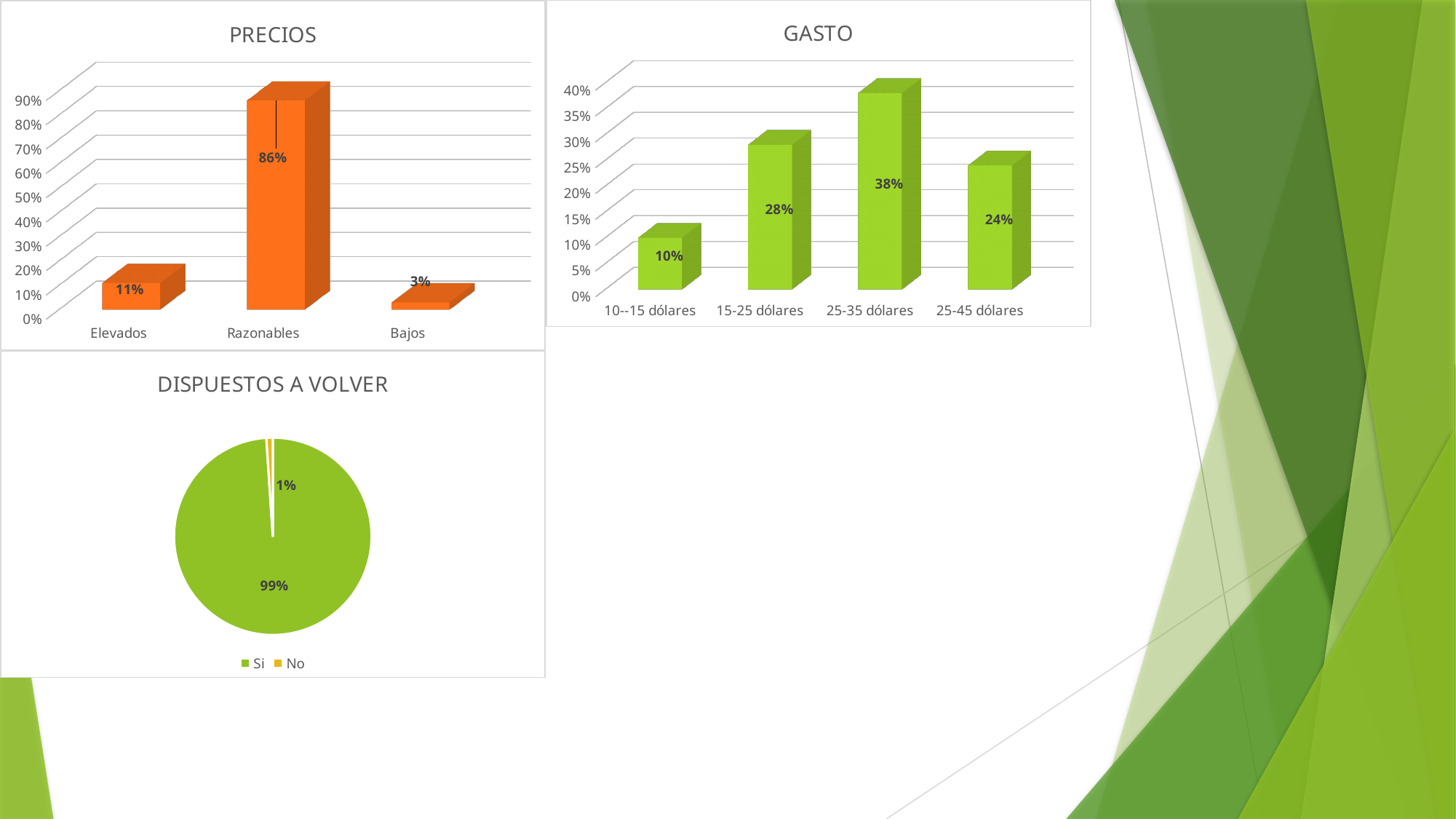
In the GASTO chart, which category has the highest value? 25-35 dólares In the PRECIOS chart, how many categories are shown? 3 In the PRECIOS chart, which category has the lowest value? Bajos What kind of chart is the GASTO chart? Bar chart What kind of chart is the DISPUESTOS A VOLVER chart? Pie chart In the GASTO chart, what is the difference between the values for 25-35 dólares and 10--15 dólares? 28% In the DISPUESTOS A VOLVER chart, what share of the pie is Si? 99% In the PRECIOS chart, what is the difference between the values for Razonables and Elevados? 75% In the GASTO chart, which is larger, the value for 15-25 dólares or the value for 25-45 dólares? 15-25 dólares In the DISPUESTOS A VOLVER chart, how many entries does the legend list? 2 In the PRECIOS chart, what is the value for Razonables? 86% In the GASTO chart, what is the value for 25-35 dólares? 38%